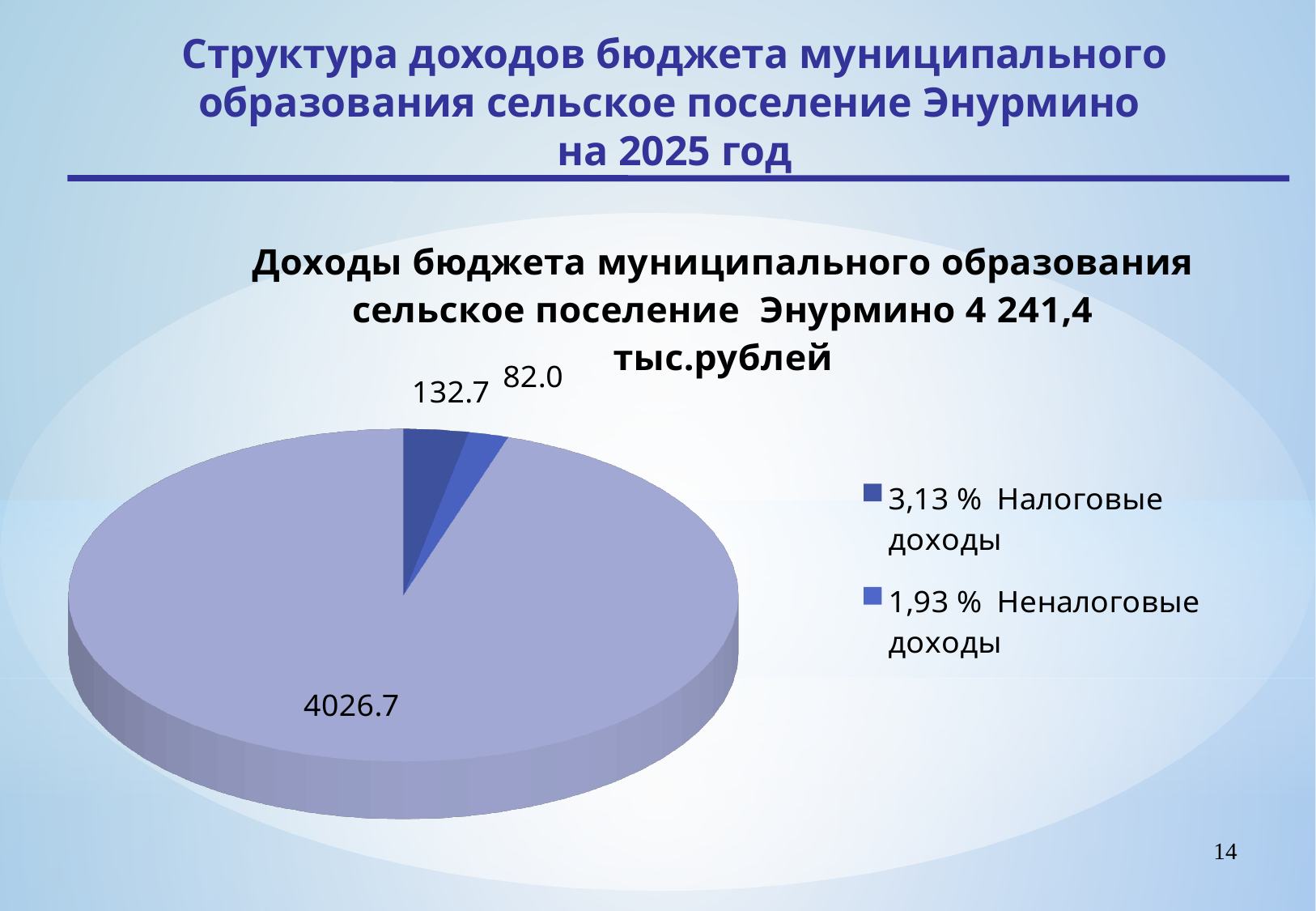
What total amount in тыс.рублей is stated in the chart title? 4 241,4 What kind of chart is shown on the slide? Pie chart Which legend category has the smallest slice in the pie chart? Неналоговые доходы What value is shown for Налоговые доходы on the pie chart? 132.7 How many slices does the pie chart have? 3 What is the difference between the values for Налоговые доходы and Неналоговые доходы? 50.7 Which is larger, the value for Налоговые доходы or the value for Неналоговые доходы? Налоговые доходы What share of the pie does Неналоговые доходы represent, according to the legend? 1,93 % What share of the pie does Налоговые доходы represent, according to the legend? 3,13 % What is the value of the largest slice of the pie chart? 4026.7 What value is shown for Неналоговые доходы on the pie chart? 82.0 How many entries does the legend of the pie chart list? 2